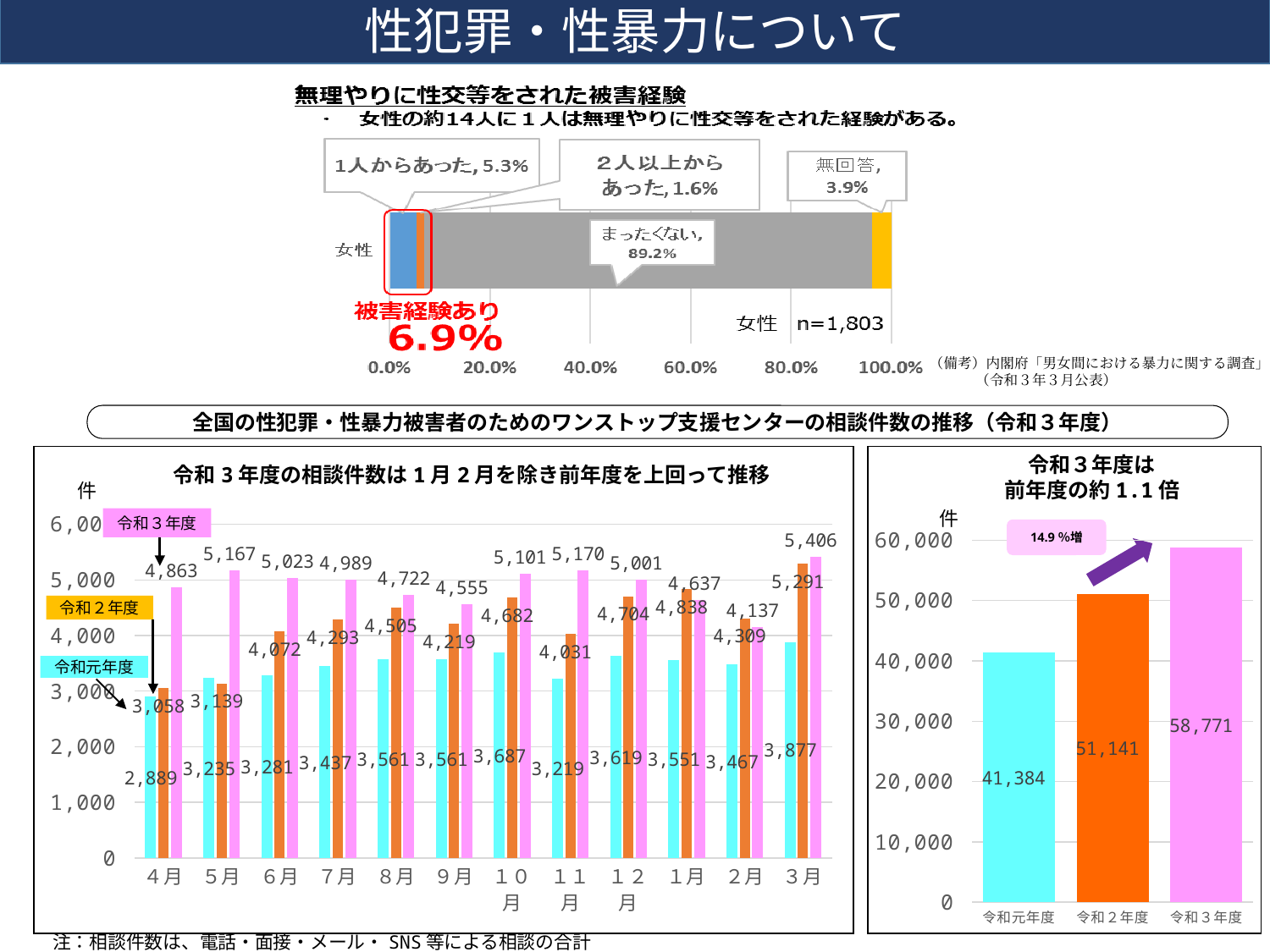
In the bottom-right chart (令和３年度は前年度の約1.1倍), what is the value for 令和３年度? 58,771 In the bottom-right chart (令和３年度は前年度の約1.1倍), what is the difference between 令和３年度 and 令和２年度? 7,630 In the bottom-left monthly chart, what is the difference between the 令和３年度 and 令和２年度 values for 4月? 1,805 What kind of chart is the bottom-right chart (令和３年度は前年度の約1.1倍)? bar chart In the bottom-right chart (令和３年度は前年度の約1.1倍), do the values rise or fall from 令和元年度 to 令和３年度? rise In the top chart (無理やりに性交等をされた被害経験), what percentage is まったくない? 89.2% In the bottom-left monthly chart, what is the 令和元年度 value for 4月? 2,889 In the bottom-right chart (令和３年度は前年度の約1.1倍), what is the value for 令和元年度? 41,384 In the bottom-left monthly chart, which is larger for 1月: 令和２年度 or 令和３年度? 令和２年度 In the bottom-right chart (令和３年度は前年度の約1.1倍), how many categories are shown on the x axis? 3 In the bottom-left monthly chart, how many series are shown? 3 In the bottom-left monthly chart, what is the 令和３年度 value for 3月? 5,406